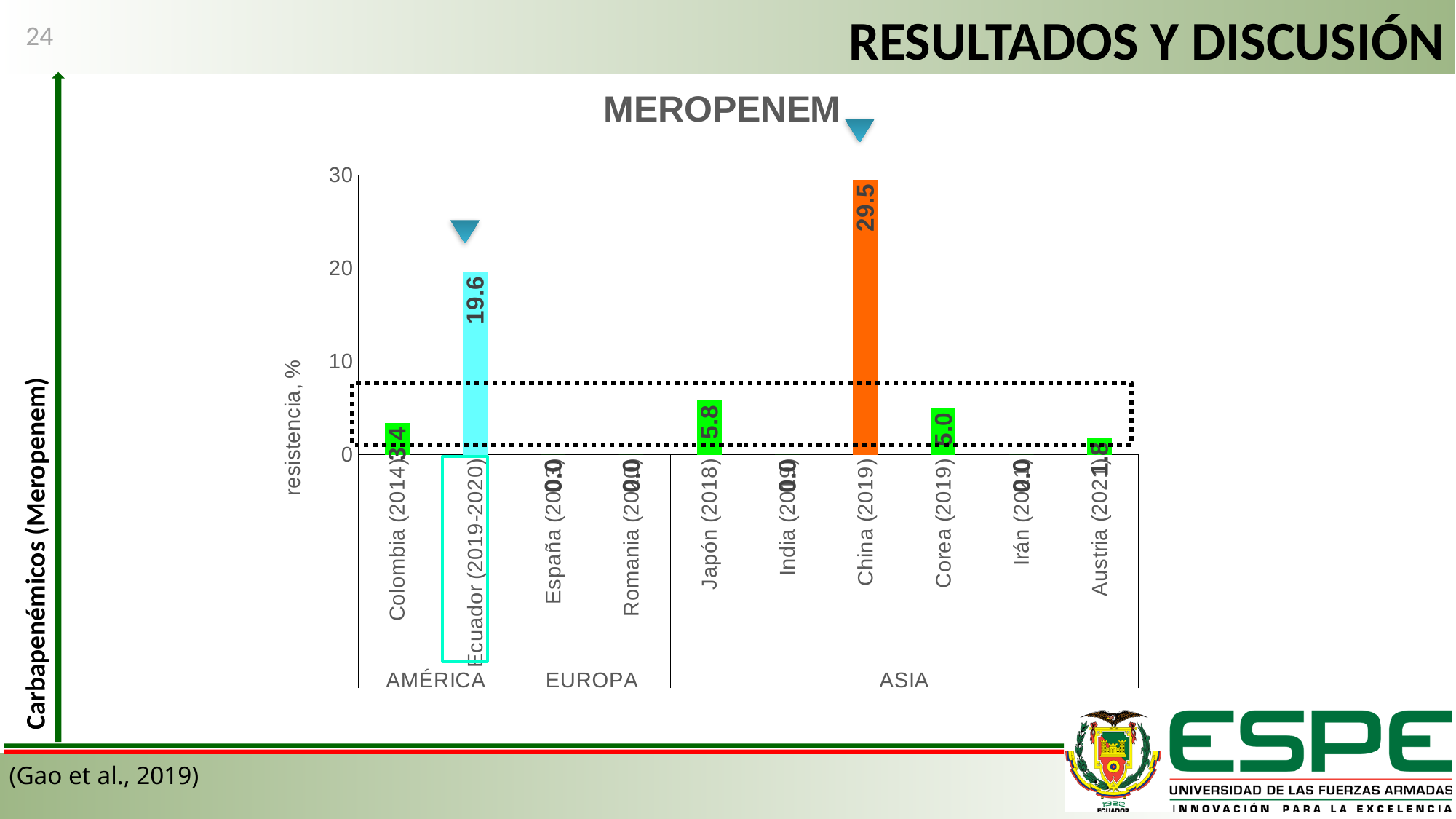
What is the resistance value for China (2019)? 29.5 How many categories are plotted on the x axis? 10 What kind of chart is shown? bar chart What is the resistance value for Colombia (2014)? 3.4 What is the resistance value for Ecuador (2019-2020)? 19.6 What is the resistance value for Corea (2019)? 5.0 Which has a larger value, Japón (2018) or Corea (2019)? Japón (2018) What is the resistance value for Austria (2021)? 1.8 Which category has the highest resistance value? China (2019) Is the value for Ecuador (2019-2020) greater or less than 10? greater What is the difference between the values for China (2019) and Ecuador (2019-2020)? 9.9 What is the resistance value for Japón (2018)? 5.8